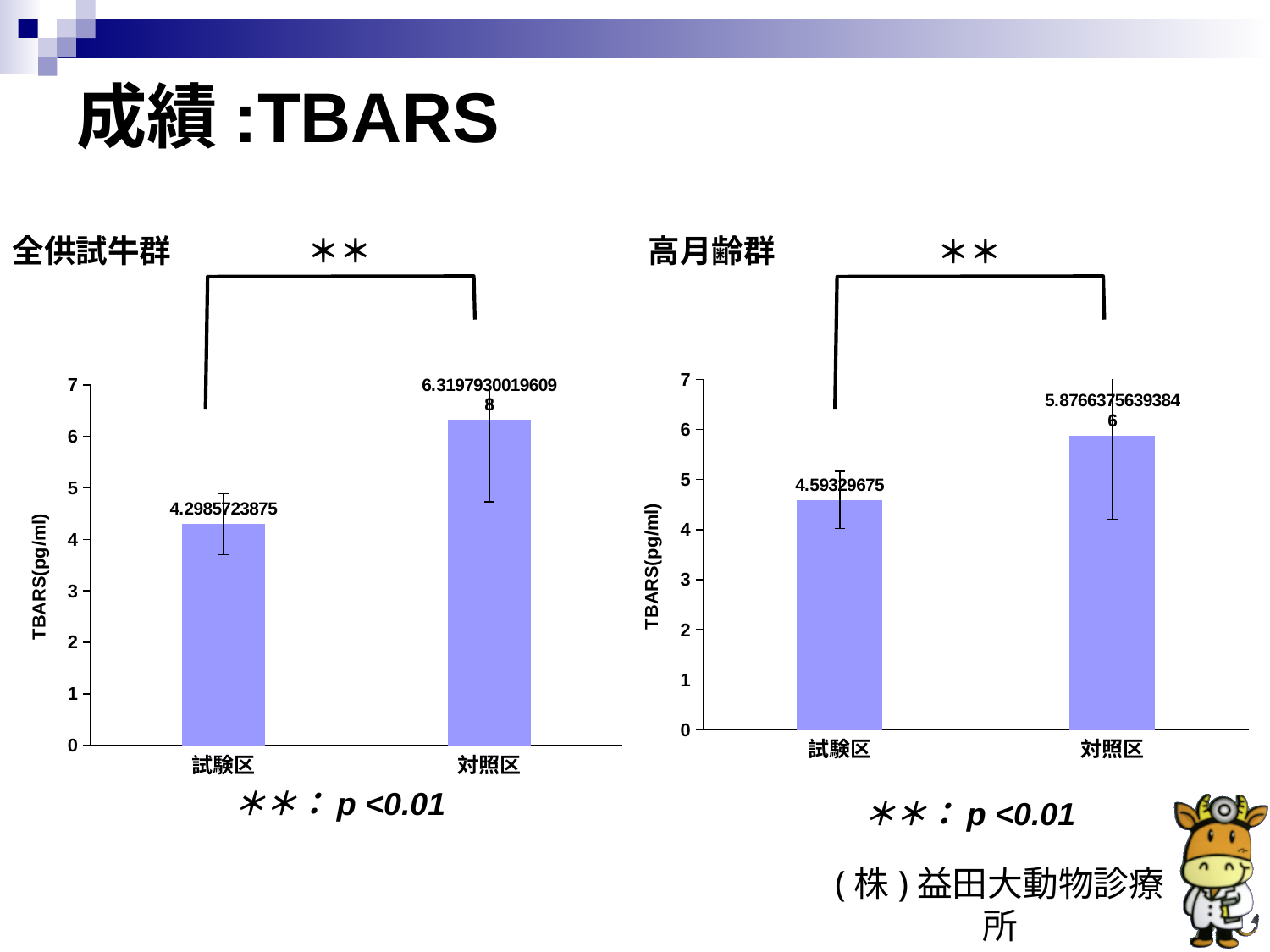
In the right chart (高月齢群), which is larger, the value for 試験区 or 対照区? 対照区 What kind of chart is the right chart (高月齢群)? bar chart How many categories are shown in the left chart (全供試牛群)? 2 In the left chart (全供試牛群), what is the value for 試験区? 4.2985723875 What p-value threshold does the ＊＊ annotation under the right chart (高月齢群) indicate? p <0.01 In the right chart (高月齢群), is the value for 対照区 greater or less than 5? greater In the right chart (高月齢群), which category has the lowest value? 試験区 In the left chart (全供試牛群), which category has the highest value? 対照区 In the right chart (高月齢群), what is the value for 試験区? 4.59329675 What is the y-axis label of the left chart (全供試牛群)? TBARS(pg/ml) In the left chart (全供試牛群), which is larger, the value for 試験区 or 対照区? 対照区 In the left chart (全供試牛群), is the value for 対照区 greater or less than 6? greater